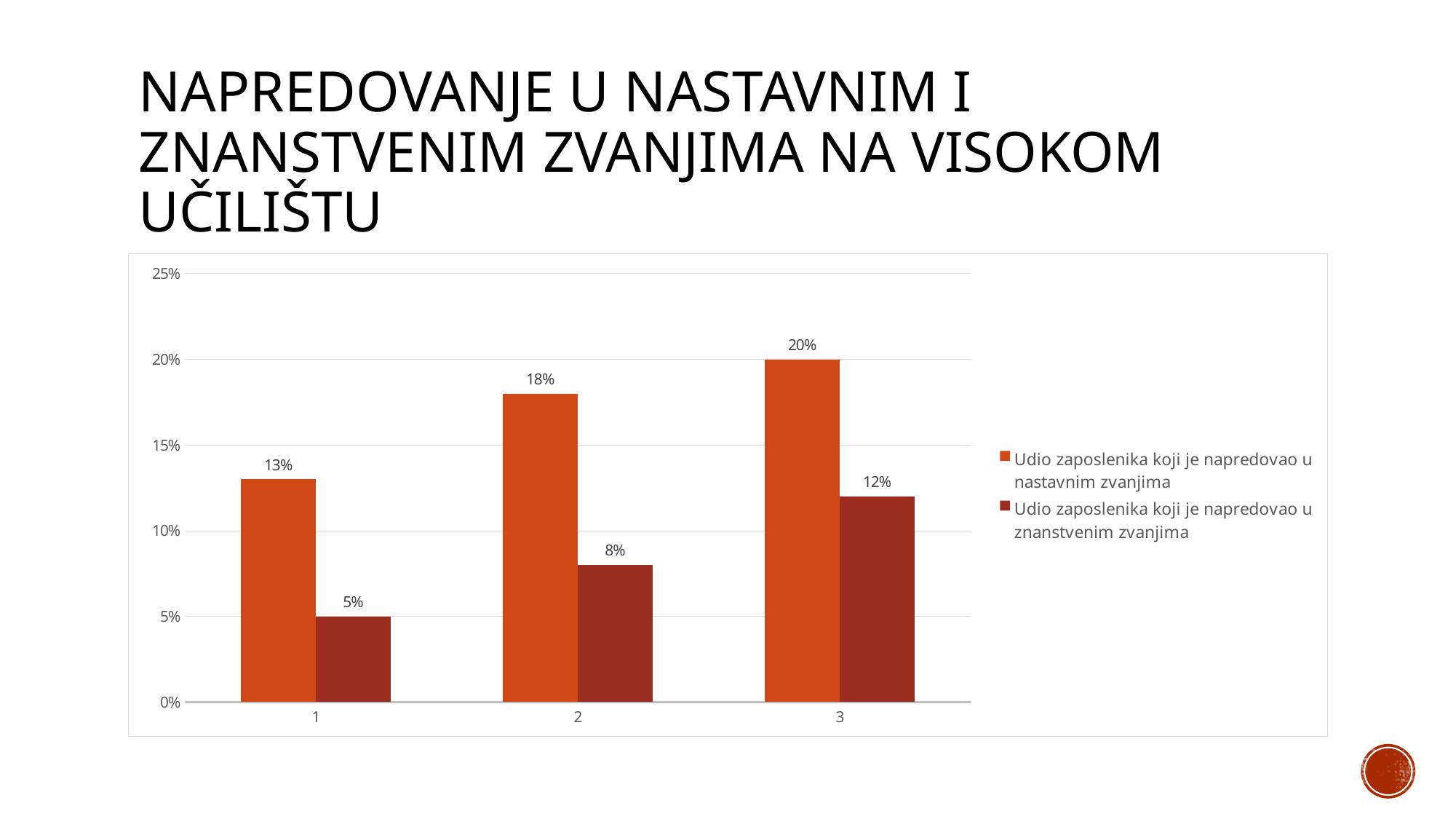
Is the value for category 2 in the series 'Udio zaposlenika koji je napredovao u znanstvenim zvanjima' greater or less than 10%? less How many categories are shown on the x axis? 3 What is the value for category 2 in the series 'Udio zaposlenika koji je napredovao u nastavnim zvanjima'? 18% What is the value for category 3 in the series 'Udio zaposlenika koji je napredovao u znanstvenim zvanjima'? 12% What is the difference between the two series' values for category 3? 8% Do the values in the series 'Udio zaposlenika koji je napredovao u nastavnim zvanjima' rise or fall from category 1 to category 3? rise Which category has the lowest value in the series 'Udio zaposlenika koji je napredovao u znanstvenim zvanjima'? 1 What kind of chart is shown on the slide? bar chart For category 1, which series has the larger value? Udio zaposlenika koji je napredovao u nastavnim zvanjima Which category has the highest value in the series 'Udio zaposlenika koji je napredovao u nastavnim zvanjima'? 3 How many series does the legend list? 2 What is the value for category 1 in the series 'Udio zaposlenika koji je napredovao u znanstvenim zvanjima'? 5%